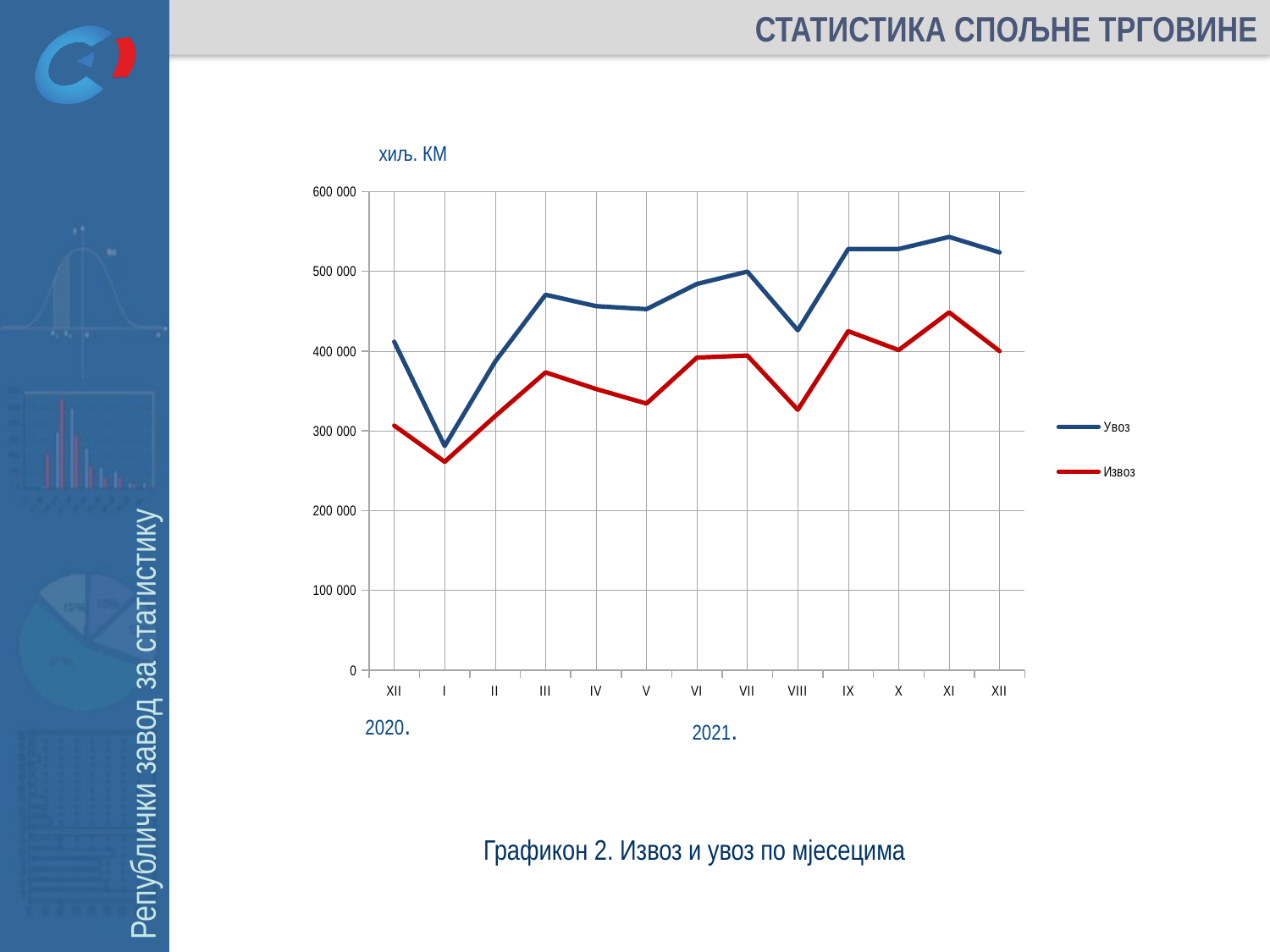
Which series has the larger value in month VII, Увоз or Извоз? Увоз What kind of chart is shown on the slide? line chart Does the Увоз series rise or fall from month I to month III? rise Is the value of Извоз in month VIII greater or less than 400 000? less How many series does the legend list? 2 In which month is the Увоз series at its lowest? I How many months are plotted along the x axis? 13 In which month is the Извоз series at its lowest? I In which month is the Извоз series at its highest? XI Is the value of Увоз in month I greater or less than 300 000? less In which month is the Увоз series at its highest? XI What are the two series named in the legend? Увоз and Извоз